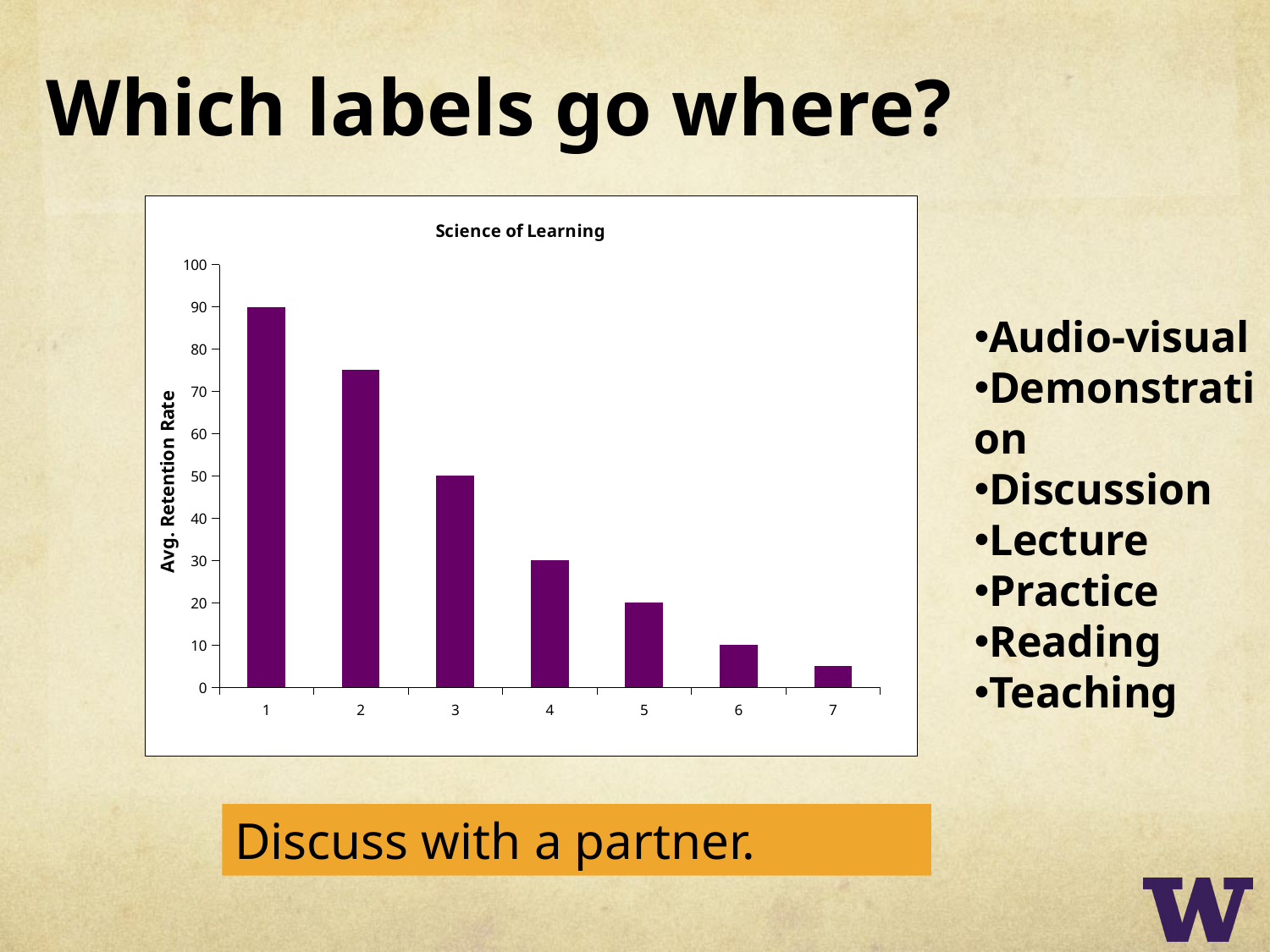
What is the title of the chart? Science of Learning Is the value for category 2 greater or less than 70? greater What is the difference between the values for category 1 and category 3? 40 What is the label of the vertical axis? Avg. Retention Rate Which category has the highest Avg. Retention Rate? 1 Do the values rise or fall from category 1 to category 7? fall What is the Avg. Retention Rate for category 5? 20 Which category has the lowest Avg. Retention Rate? 7 What is the Avg. Retention Rate for category 1? 90 What is the Avg. Retention Rate for category 3? 50 What kind of chart is shown on the slide? bar chart How many bars are plotted in the chart? 7